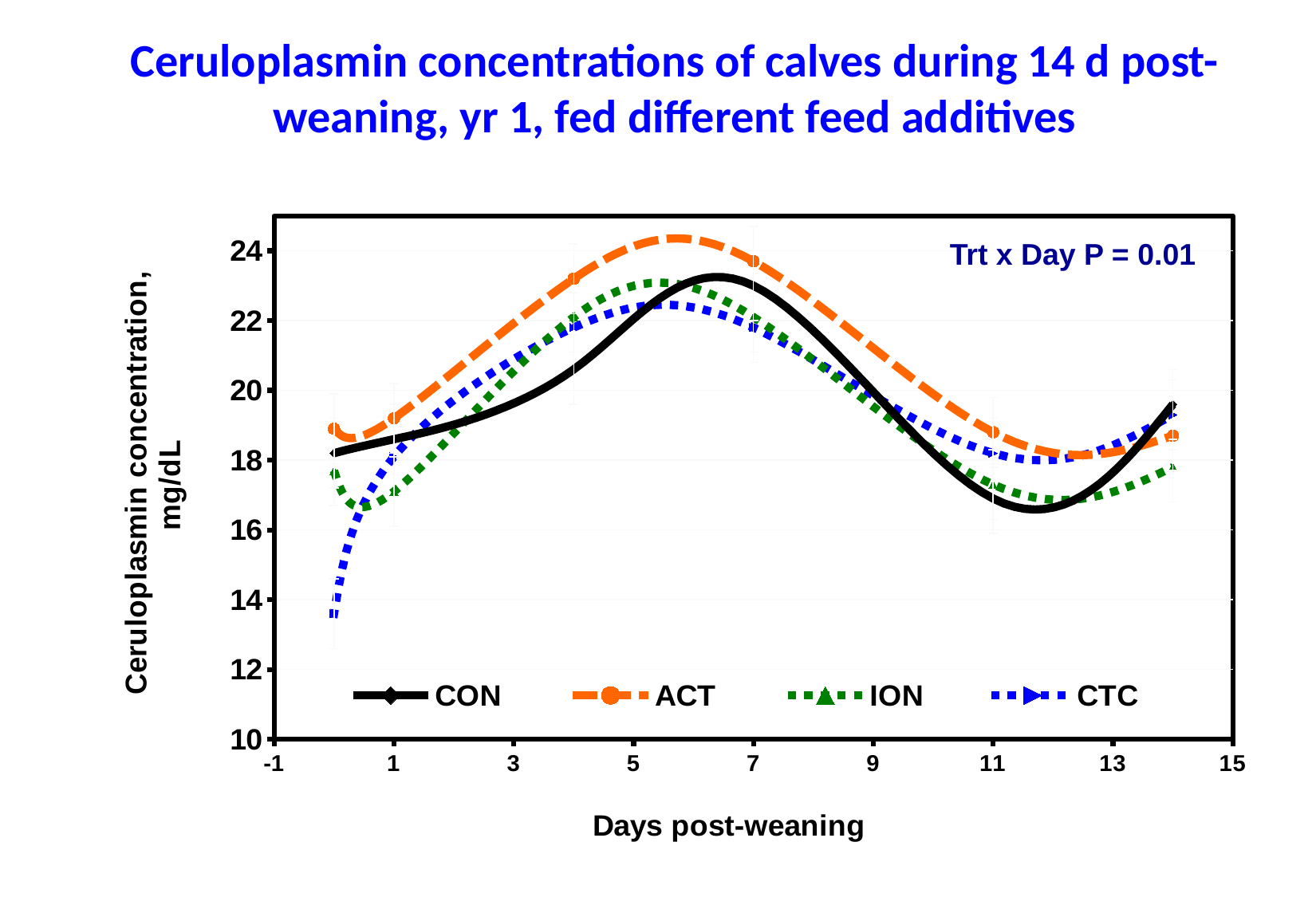
Which series are listed in the legend? CON, ACT, ION, CTC Does the CON line rise or fall between day 7 and day 12? fall How many series does the legend list? 4 Is the value for CON at day 14 greater or less than 20? less Is the value for ION at day 0 greater or less than 18? less Is the value for CTC at day 0 greater or less than 14? less At day 7, which is larger, the value for ACT or the value for CON? ACT Which series has the lowest value at day 0? CTC What kind of chart is shown on the slide? line chart Which series reaches the highest ceruloplasmin concentration on the chart? ACT What P value is printed on the chart for the Trt x Day interaction? 0.01